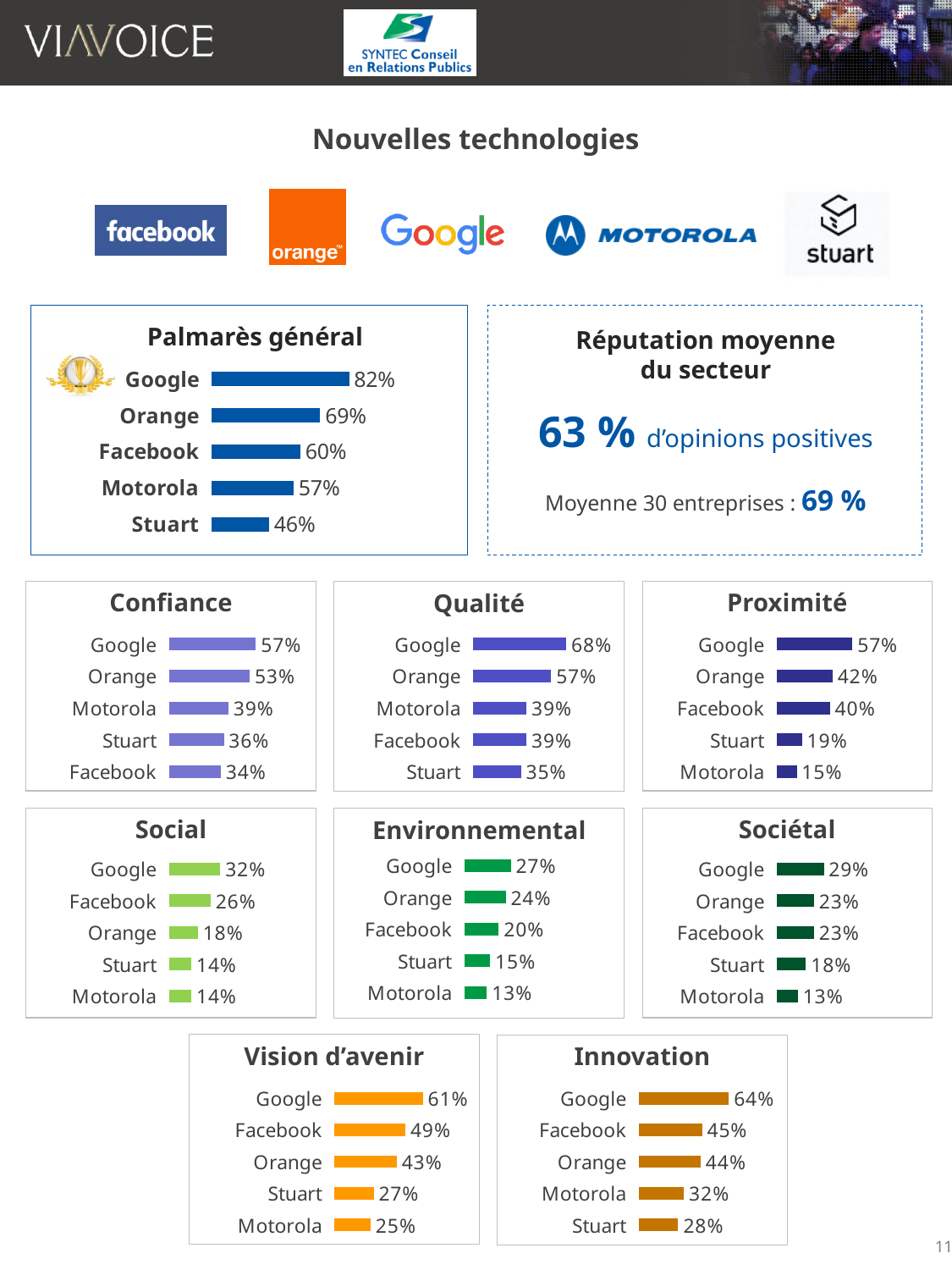
What type of chart is the 'Palmarès général' chart? Bar chart In the 'Innovation' chart, what is the value for Orange? 44% In the 'Qualité' chart, which company has the highest value? Google In the 'Palmarès général' chart, what is the value for Google? 82% In the 'Social' chart, which is larger, the value for Facebook or the value for Orange? Facebook In the 'Palmarès général' chart, what is the difference between Orange and Facebook? 9% In the 'Environnemental' chart, what is the difference between Google and Motorola? 14% In the 'Confiance' chart, what is the value for Facebook? 34% In the 'Sociétal' chart, what is the value for Stuart? 18% In the 'Proximité' chart, what is the value for Motorola? 15% In the 'Vision d'avenir' chart, how many companies are shown? 5 In the 'Palmarès général' chart, which company has the lowest value? Stuart